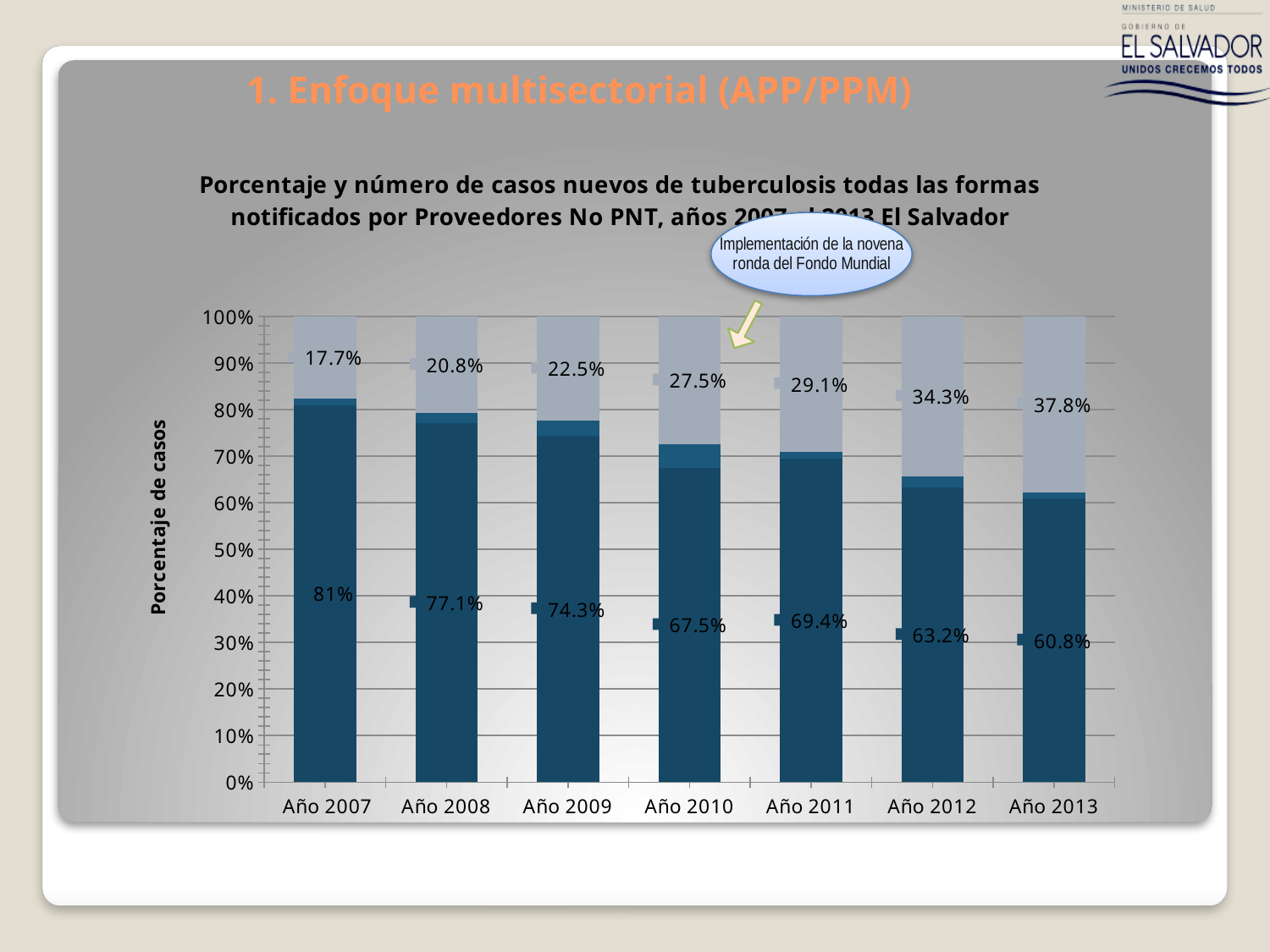
What is the value of the light blue (upper) segment for Año 2013? 37.8% What is the value of the dark blue (lower) segment for Año 2011? 69.4% What kind of chart is shown on the slide? Stacked bar chart Which year has the lowest value for the dark blue (lower) segment? Año 2013 What is the title of the y axis? Porcentaje de casos Which year has the highest value for the light blue (upper) segment? Año 2013 By how many percentage points does the dark blue (lower) segment for Año 2007 exceed that for Año 2013? 20.2% What is the value of the dark blue (lower) segment for Año 2007? 81% Which year has the larger light blue (upper) segment, Año 2010 or Año 2011? Año 2011 What is the value of the light blue (upper) segment for Año 2009? 22.5% How many years are shown on the x axis? 7 Does the light blue (upper) segment rise or fall from Año 2007 to Año 2013? Rises